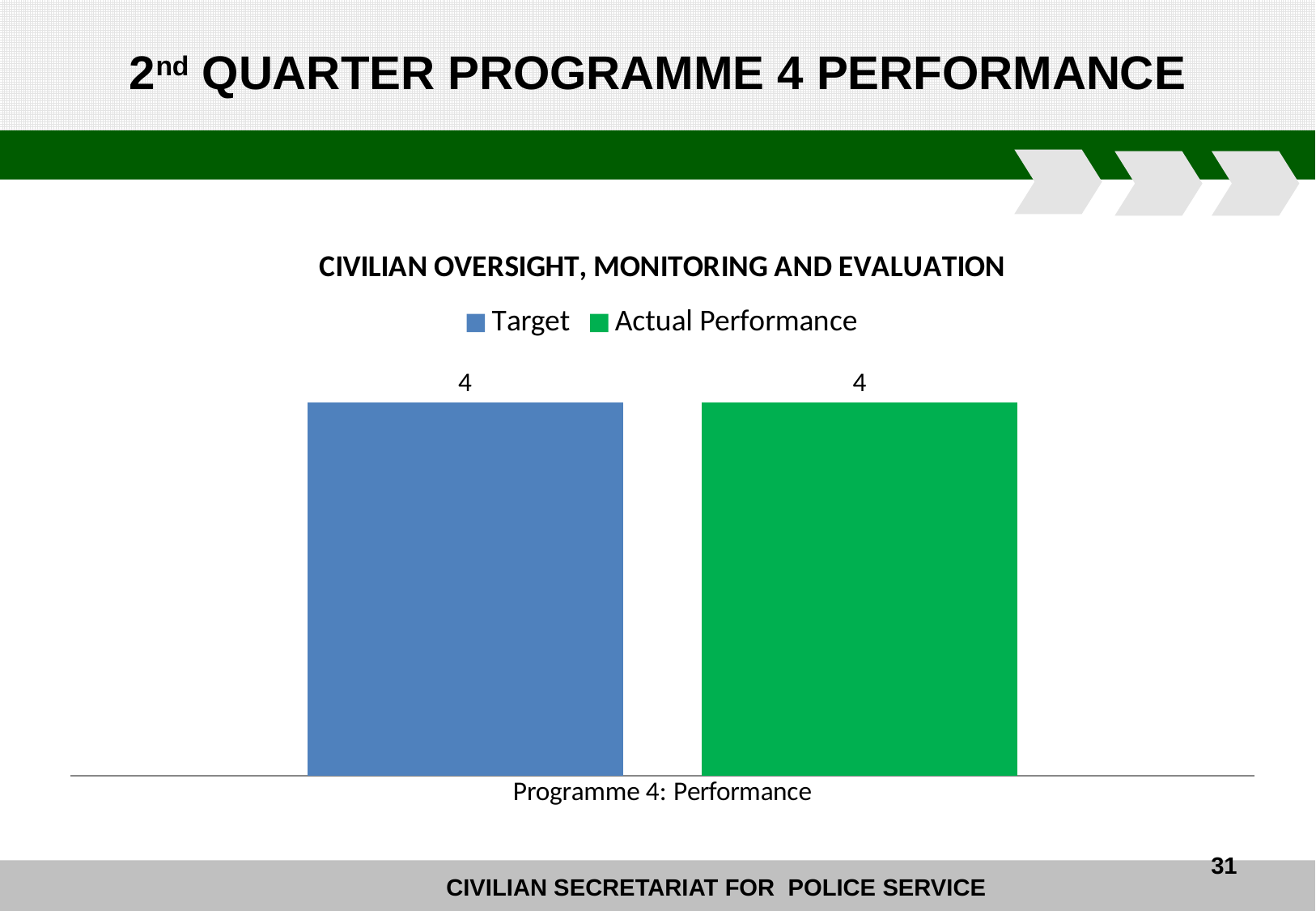
What is the title of the chart? CIVILIAN OVERSIGHT, MONITORING AND EVALUATION Which series is shown in green in the chart? Actual Performance What is the value of the Target bar for Programme 4: Performance? 4 What is the difference between the Target and Actual Performance values for Programme 4: Performance? 0 What kind of chart is shown on the slide? Bar chart What is the value of the Actual Performance bar for Programme 4: Performance? 4 How many series does the legend list? 2 How many categories are shown on the x axis of the chart? 1 What is the category label shown on the x axis of the chart? Programme 4: Performance